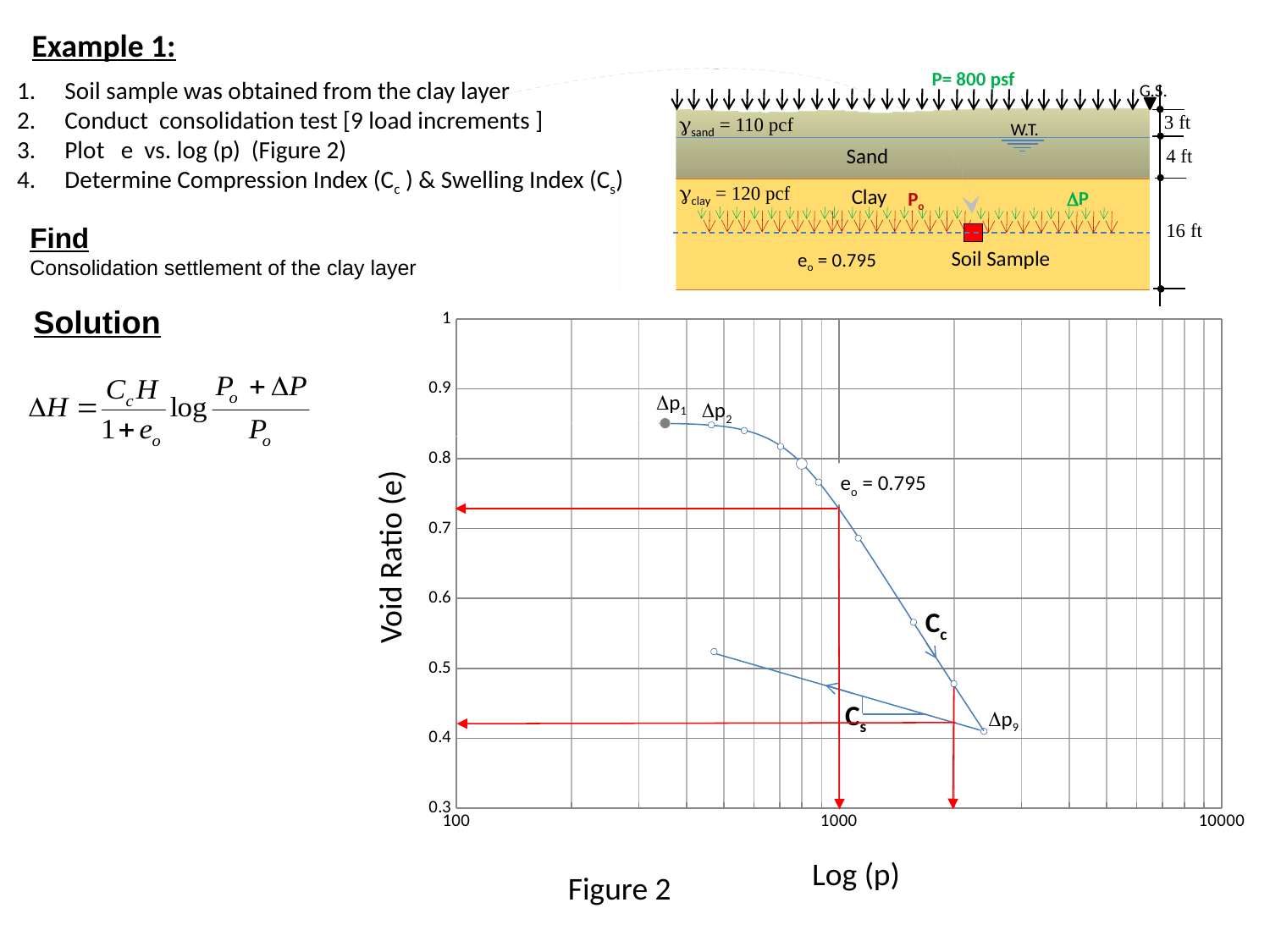
In Figure 2, is the void ratio at point Δp9 greater or less than 0.5? less In Figure 2, does the void ratio rise or fall along the loading curve as p increases from Δp1 to Δp9? fall What is the initial void ratio e_o labelled on the chart in Figure 2? 0.795 What kind of chart is Figure 2? line chart What is the lowest value shown on the y axis of Figure 2? 0.3 What is the label of the x axis in Figure 2? Log (p) In Figure 2, is the void ratio at point Δp2 greater or less than 0.8? greater In Figure 2, is the void ratio at point Δp1 greater or less than 0.8? greater In Figure 2, which labelled point has the lowest void ratio? Δp9 What is the label of the y axis in Figure 2? Void Ratio (e) In Figure 2, which labelled point has the highest void ratio? Δp1 In Figure 2, which point has the higher void ratio, Δp1 or Δp9? Δp1